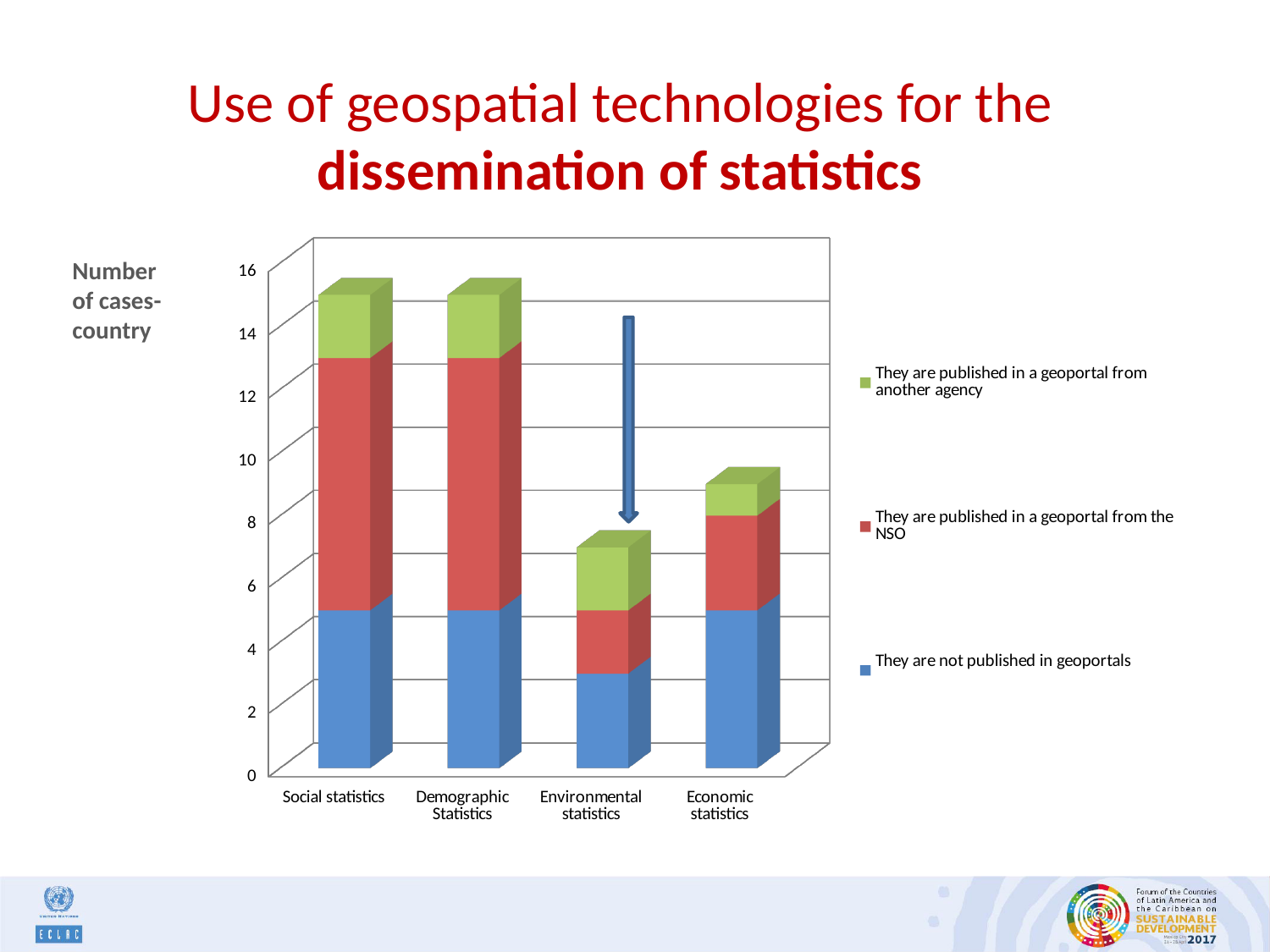
How many series does the chart's legend list? 3 Is the total bar for Environmental statistics greater or less than 10? less What is the label on the vertical axis of the chart? Number of cases-country Is the total bar for Economic statistics greater or less than 12? less What colour represents the series 'They are not published in geoportals'? Blue Is the total bar for Social statistics greater or less than 12? greater How many categories are shown on the x axis of the chart? 4 Which has the larger total bar, Social statistics or Economic statistics? Social statistics What kind of chart is shown on the slide? Stacked bar chart Which category has the lowest total bar height? Environmental statistics Which has the larger total bar, Economic statistics or Environmental statistics? Economic statistics